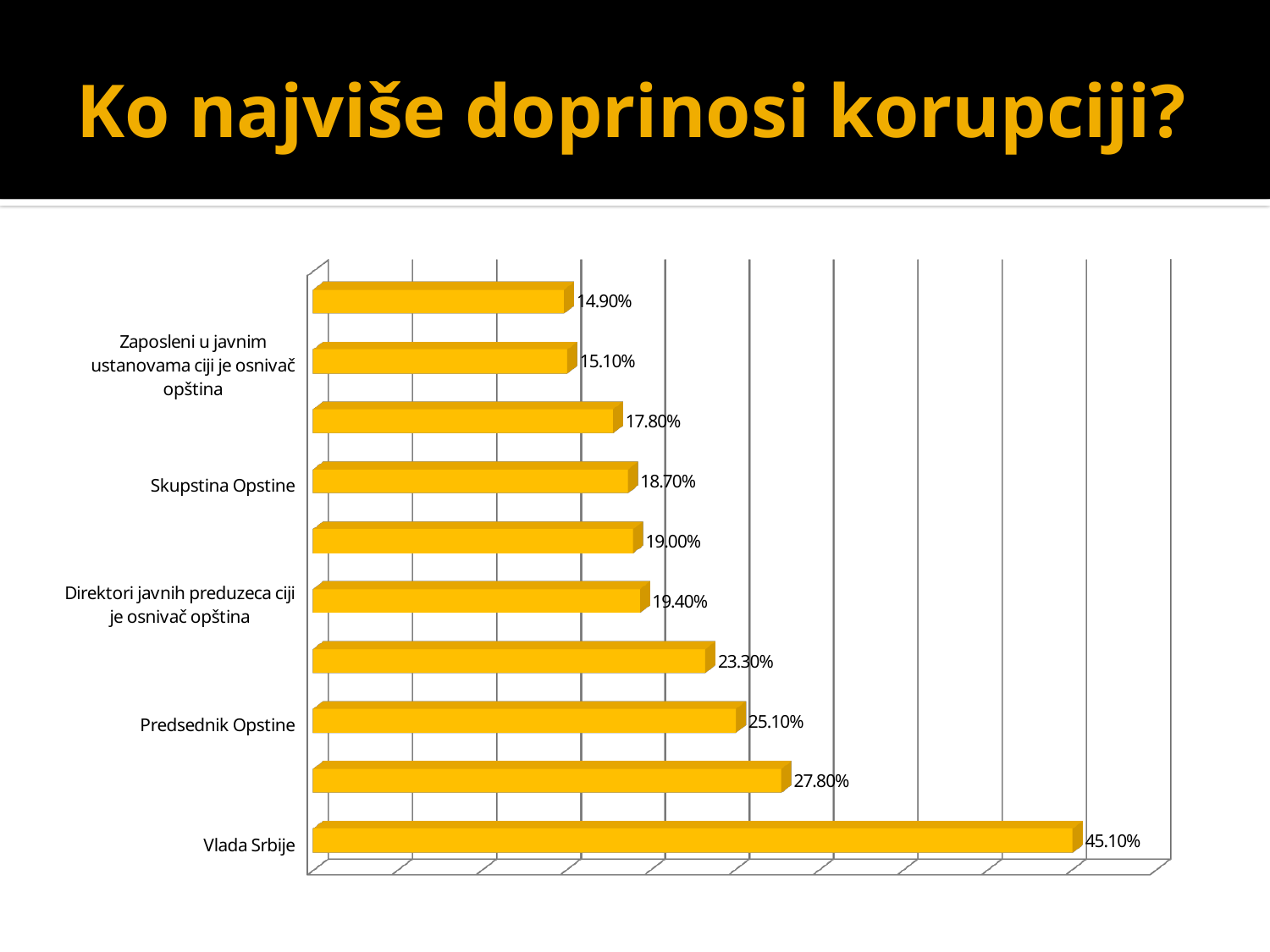
What is the value for Vlada Srbije? 45.10% What kind of chart is shown on the slide? Bar chart What is the value for Zaposleni u javnim ustanovama ciji je osnivač opština? 15.10% Which category has the highest value? Vlada Srbije What is the value for Skupstina Opstine? 18.70% What is the title of the slide? Ko najviše doprinosi korupciji? What is the difference between the values for Vlada Srbije and Predsednik Opstine? 20.00% How many bars are plotted on the chart? 10 What is the value for Predsednik Opstine? 25.10% What is the smallest value shown on the chart? 14.90% Which is larger, the value for Predsednik Opstine or the value for Skupstina Opstine? Predsednik Opstine What is the value for Direktori javnih preduzeca ciji je osnivač opština? 19.40%